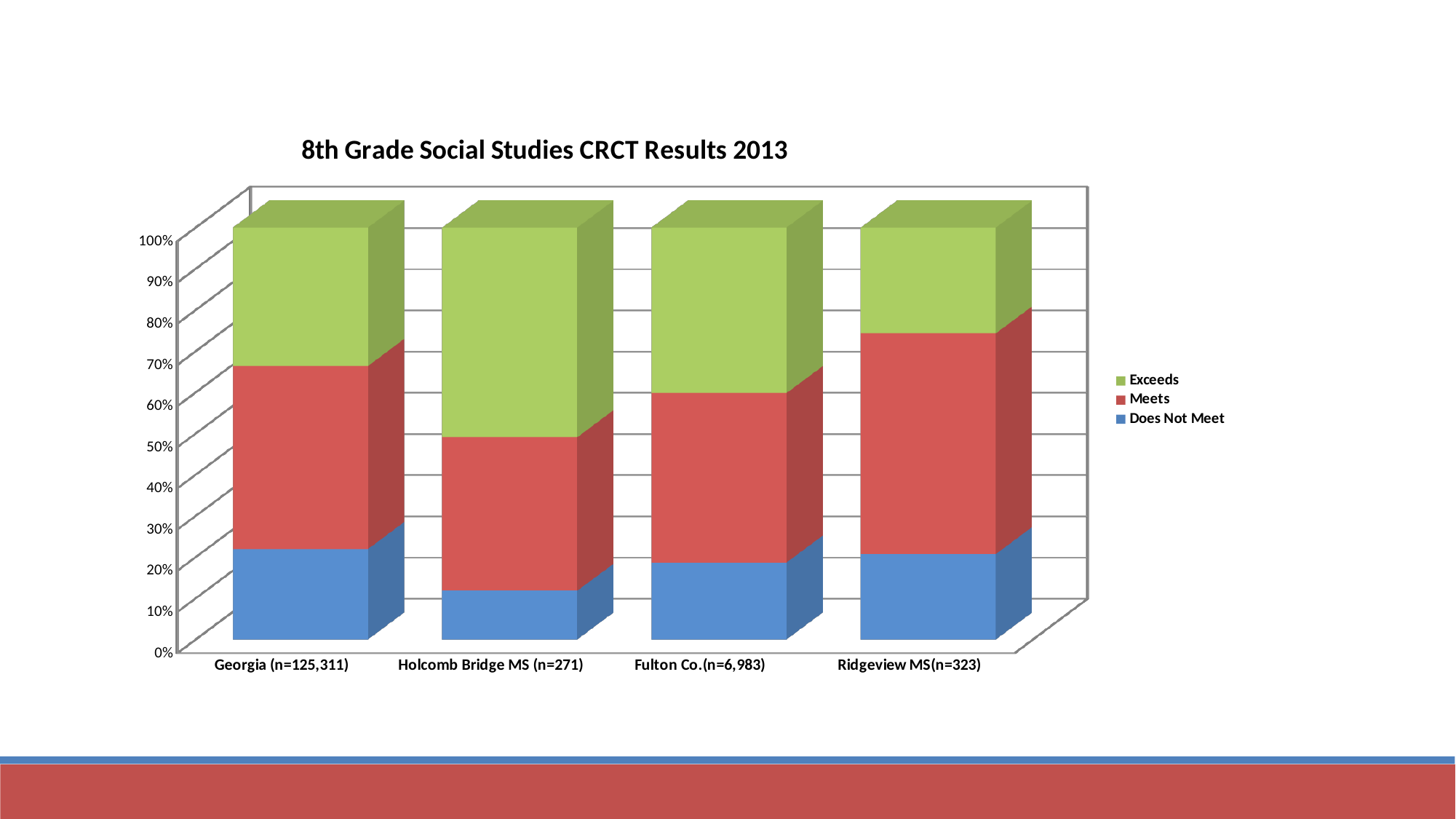
What is the title of the chart? 8th Grade Social Studies CRCT Results 2013 Which category has the smallest Does Not Meet segment? Holcomb Bridge MS (n=271) How many series does the legend list? 3 Is the Exceeds segment larger for Holcomb Bridge MS (n=271) or Ridgeview MS(n=323)? Holcomb Bridge MS (n=271) Is the Exceeds value for Holcomb Bridge MS (n=271) greater or less than 40%? greater How many categories are shown along the x axis? 4 Which category has the smallest Exceeds segment? Ridgeview MS(n=323) Which series is shown in green in the legend? Exceeds What kind of chart is shown on the slide? Stacked bar chart Is the Does Not Meet value for Holcomb Bridge MS (n=271) greater or less than 20%? less Which category has the largest Exceeds segment? Holcomb Bridge MS (n=271) Which category has the largest Meets segment? Ridgeview MS(n=323)